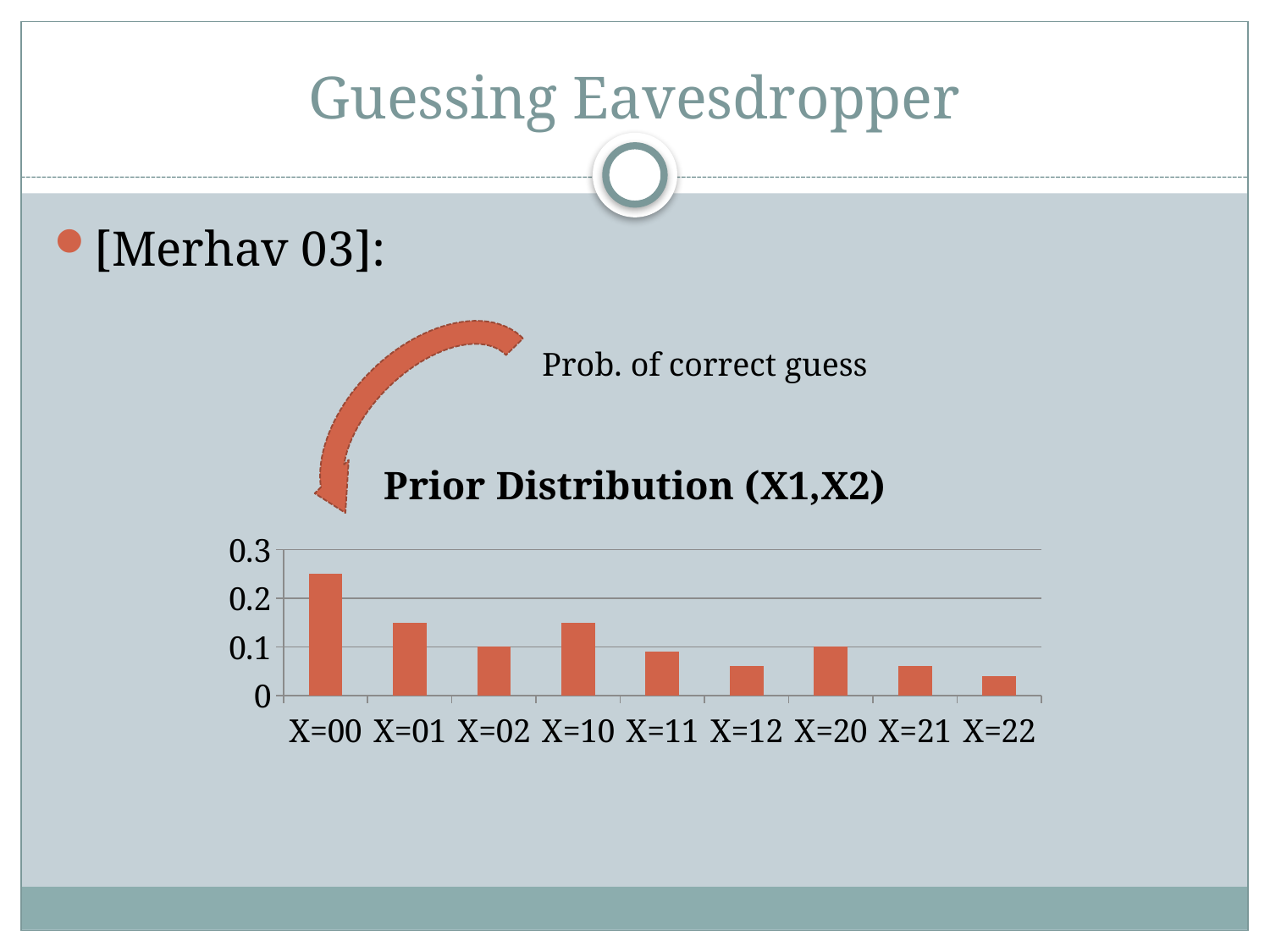
Is the value for X=01 greater or less than 0.2? less Which is larger, the value for X=00 or the value for X=01? X=00 Which category has the lowest value in the chart? X=22 Is the value for X=22 greater or less than 0.1? less Which is larger, the value for X=02 or the value for X=22? X=02 How many categories are shown on the x axis of the chart? 9 Is the value for X=12 greater or less than 0.1? less What is the title of the chart? Prior Distribution (X1,X2) Which category has the highest value in the chart? X=00 What kind of chart is shown on the slide? bar chart